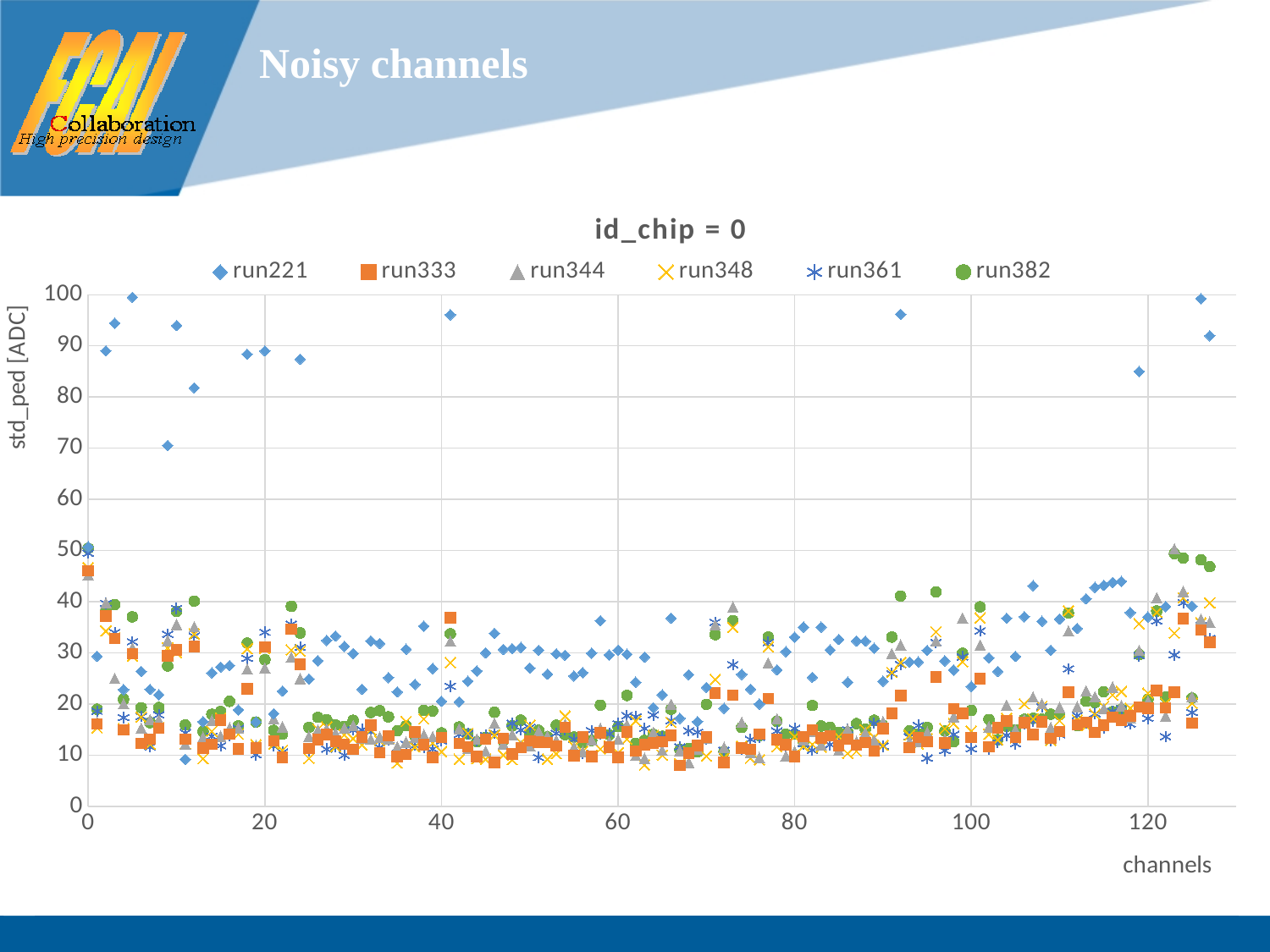
What is the title of the chart? id_chip = 0 What kind of chart is shown on the slide? scatter chart Is the run221 point near channel 9 greater or less than 60? greater Is the run221 value at channel 91 greater or less than 90? greater Is the run333 value at channel 41 greater or less than 30? greater How many series does the legend of the chart list? 6 Which series contains the highest std_ped values on the chart? run221 What is the label of the vertical axis of the chart? std_ped [ADC]